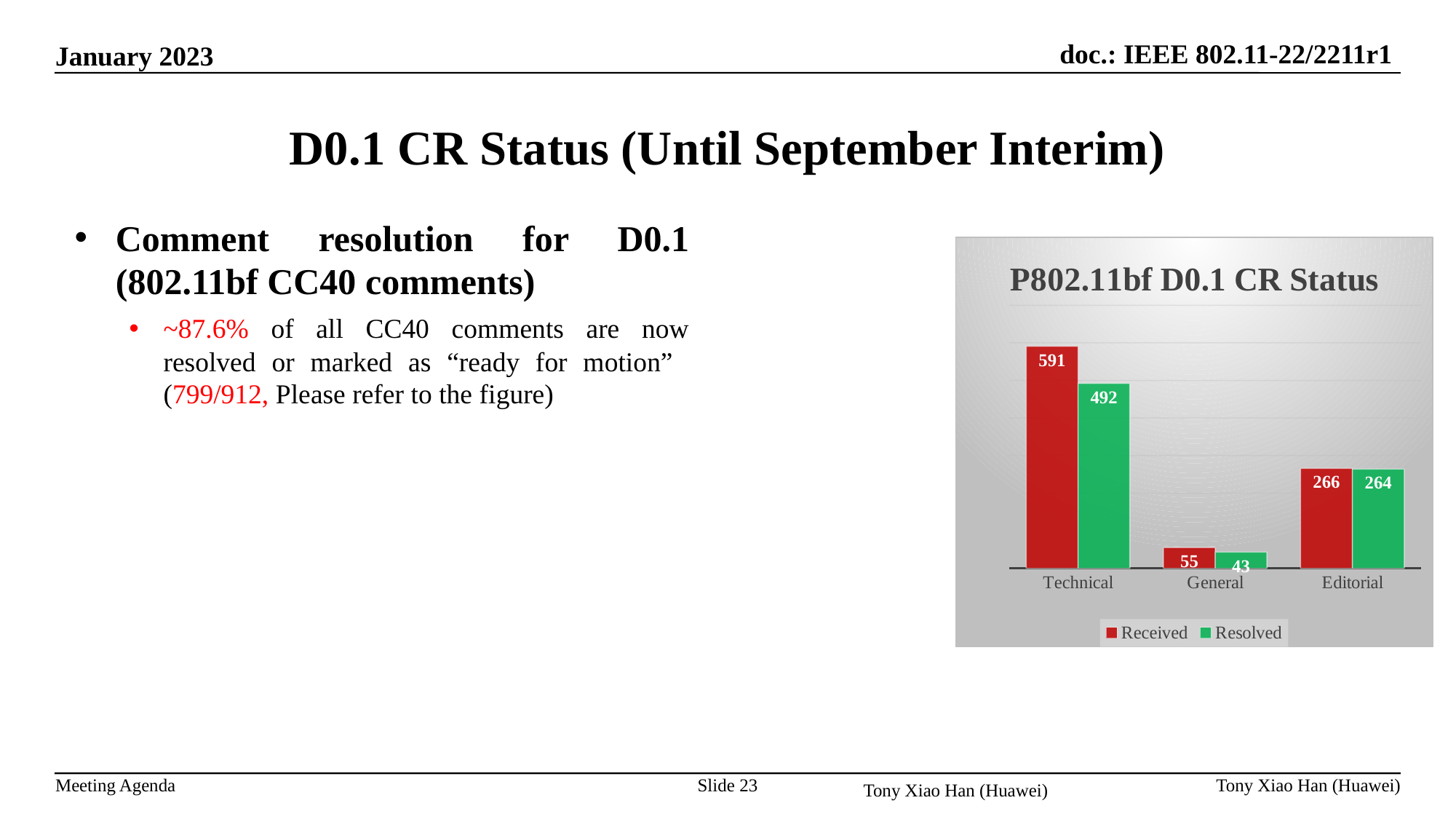
How many categories are shown on the x axis? 3 Which category has the lowest Resolved value? General What is the difference between Received and Resolved for General comments? 12 What is the Resolved value for General comments? 43 How many series does the legend list? 2 Which category has the highest Received value? Technical What is the title of the chart? P802.11bf D0.1 CR Status Which is larger, the Received value for Editorial or the Received value for General? Editorial What kind of chart is shown on the slide? Bar chart What is the difference between Received and Resolved for Technical comments? 99 What is the Received value for Technical comments? 591 What is the Resolved value for Editorial comments? 264